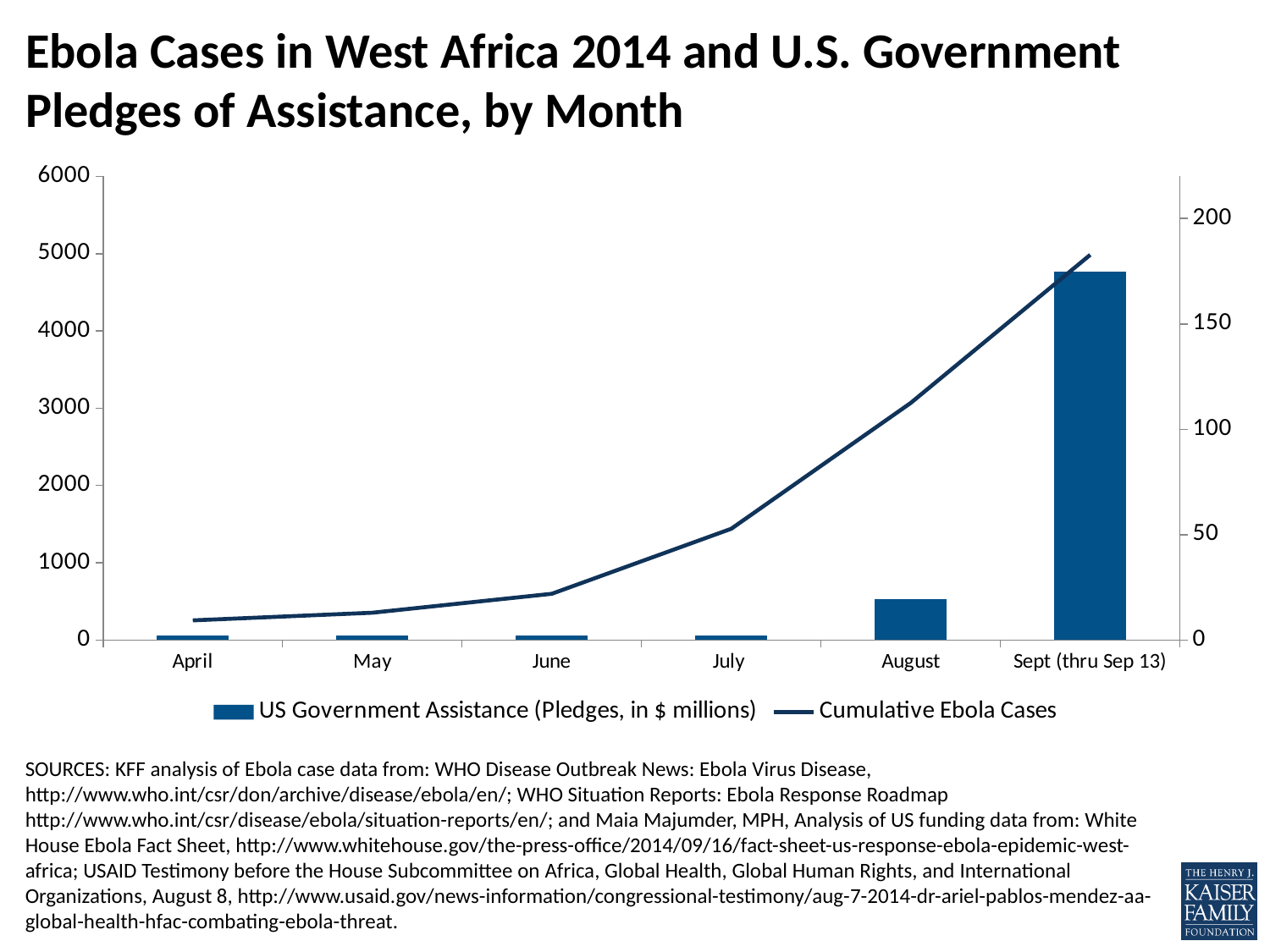
Which month has the highest US Government Assistance pledge bar? Sept (thru Sep 13) Is the Cumulative Ebola Cases value for June greater or less than 1000? less Does the Cumulative Ebola Cases line rise or fall from April to September? Rises How many series does the chart's legend list? 2 How many months are shown on the x axis of the chart? 6 Is the US Government Assistance pledge for August greater or less than 50 on the right axis? less What kind of chart is shown on the slide? A combination bar and line chart Which is larger, the US Government Assistance pledge bar for August or for Sept (thru Sep 13)? Sept (thru Sep 13) Is the Cumulative Ebola Cases value for July greater or less than 1000? greater Which series is plotted as a line in the chart? Cumulative Ebola Cases Which month has the lowest value on the Cumulative Ebola Cases line? April